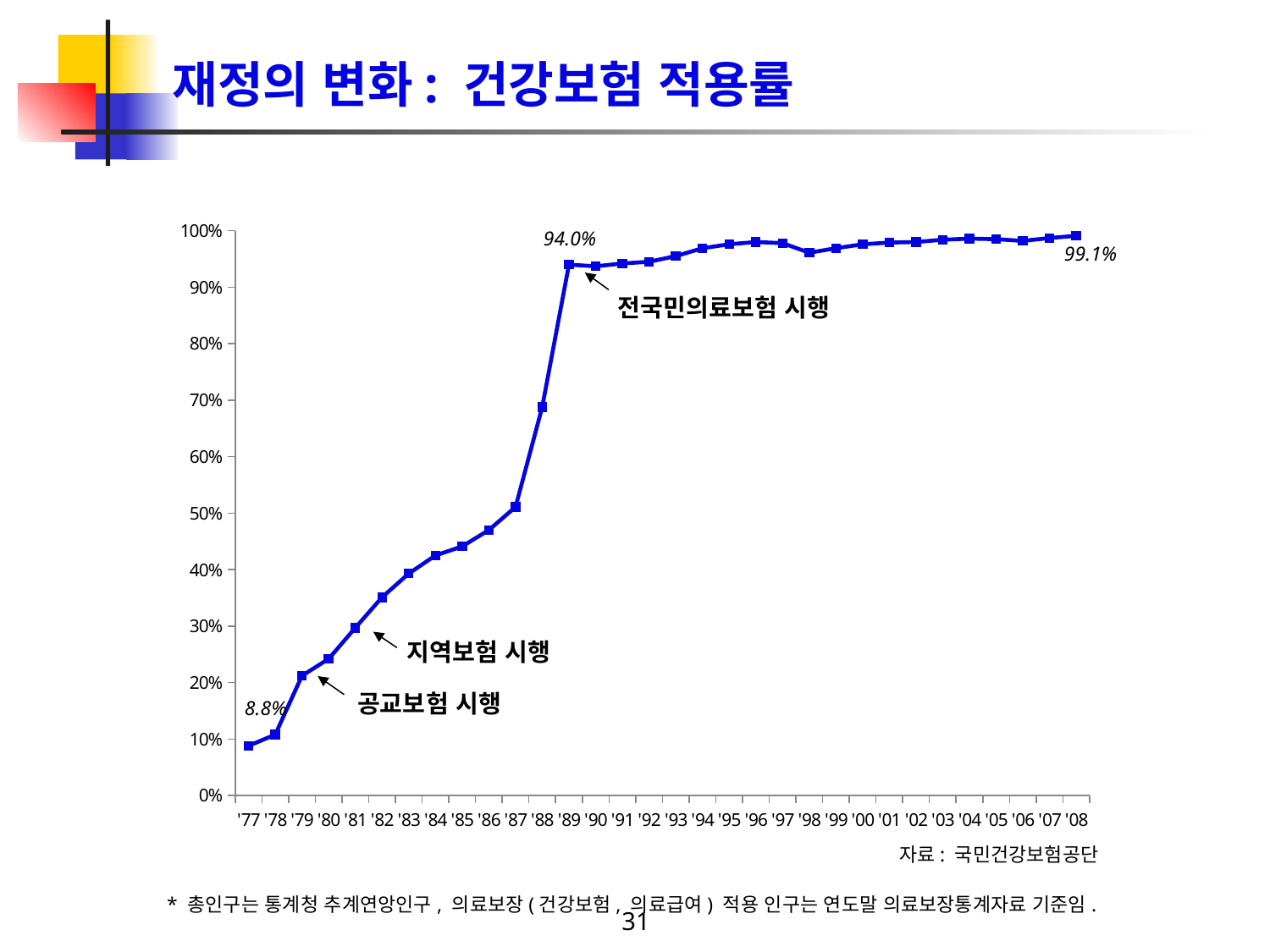
Is the value for '84 greater or less than 50%? less What is the value for '77? 8.8% What is the difference between the values for '89 and '77? 85.2% What is the difference between the values for '08 and '77? 90.3% Is the value for '88 greater or less than 60%? greater Which is larger, the value for '87 or the value for '82? '87 What is the value for '89? 94.0% What is the value for '08? 99.1% Which year has the highest value? '08 What kind of chart is shown on the slide? line chart Which year has the lowest value? '77 Do the values generally rise or fall from '77 to '08? rise